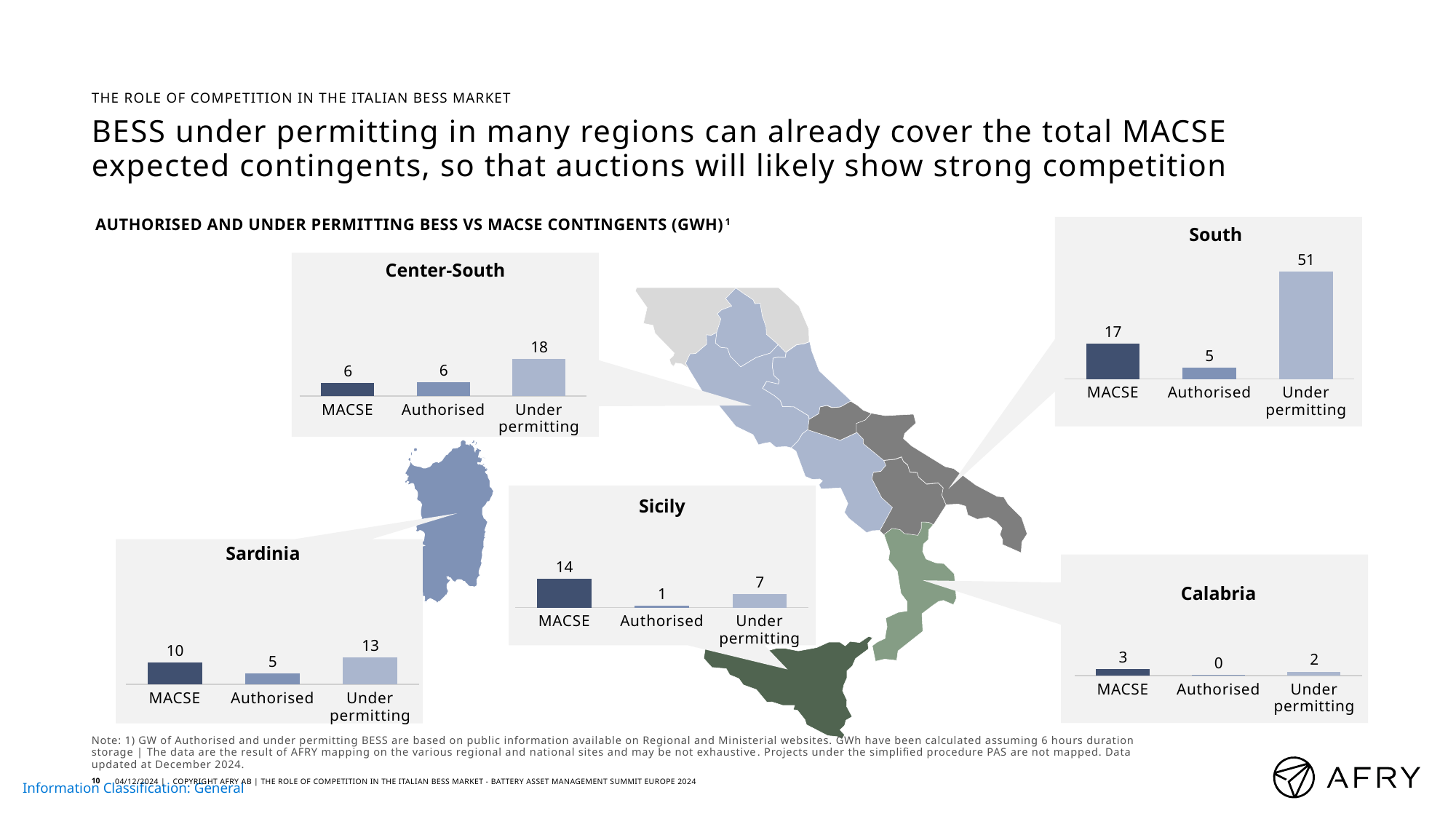
In the South chart, what is the value for Under permitting? 51 How many bars does the Calabria chart show? 3 In the Sicily chart, what is the value for Authorised? 1 How many regional charts are shown on the slide? 5 In the Center-South chart, what is the value for MACSE? 6 In the Sardinia chart, what is the difference between Under permitting and MACSE? 3 What type of chart is used for each region on the slide? Bar chart In the Calabria chart, what is the value for Authorised? 0 In the Sardinia chart, which category has the highest value? Under permitting In the Sicily chart, which category has the lowest value? Authorised In the South chart, what is the difference between Under permitting and MACSE? 34 In the Sicily chart, which is larger, MACSE or Under permitting? MACSE